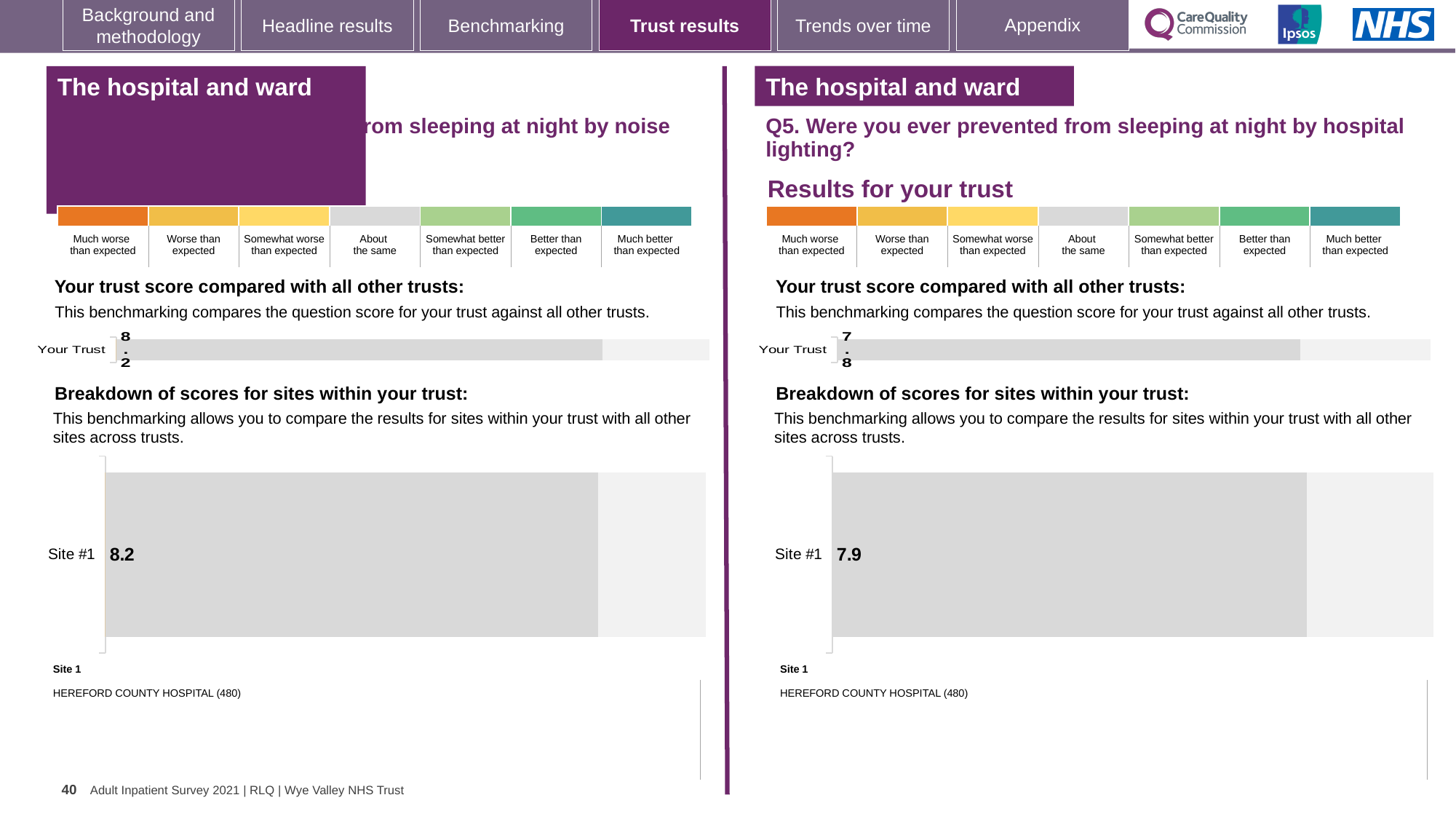
What type of chart is used to show the Site #1 score in the 'Breakdown of scores for sites within your trust' section? Bar chart On the right-hand half of the slide (Q5, hospital lighting), what is the score shown for Your Trust in the 'Your trust score compared with all other trusts' chart? 7.8 According to the key below the breakdown charts, which hospital is Site 1? HEREFORD COUNTY HOSPITAL (480) How many sites are plotted in the 'Breakdown of scores for sites within your trust' chart on the right-hand half of the slide? 1 What is the difference between the Your Trust score on the left-hand half of the slide and the Your Trust score on the right-hand half (Q5)? 0.4 On the right-hand half of the slide (Q5, hospital lighting), what score is shown for Site #1 in the 'Breakdown of scores for sites within your trust' chart? 7.9 Comparing the Site #1 scores in the two 'Breakdown of scores for sites' charts, which half of the slide shows the higher Site #1 score? The left-hand half (8.2) On the left-hand half of the slide (the noise question), what score is shown for Site #1 in the 'Breakdown of scores for sites within your trust' chart? 8.2 On the right-hand half of the slide (Q5, hospital lighting), what is the difference between the Site #1 score and the Your Trust score? 0.1 On the right-hand half of the slide (Q5, hospital lighting), which is larger: the Site #1 score or the Your Trust score? Site #1 How many categories are shown in the coloured benchmarking scale above the 'Your trust score' charts? 7 On the left-hand half of the slide (the noise question), what is the score shown for Your Trust in the 'Your trust score compared with all other trusts' chart? 8.2